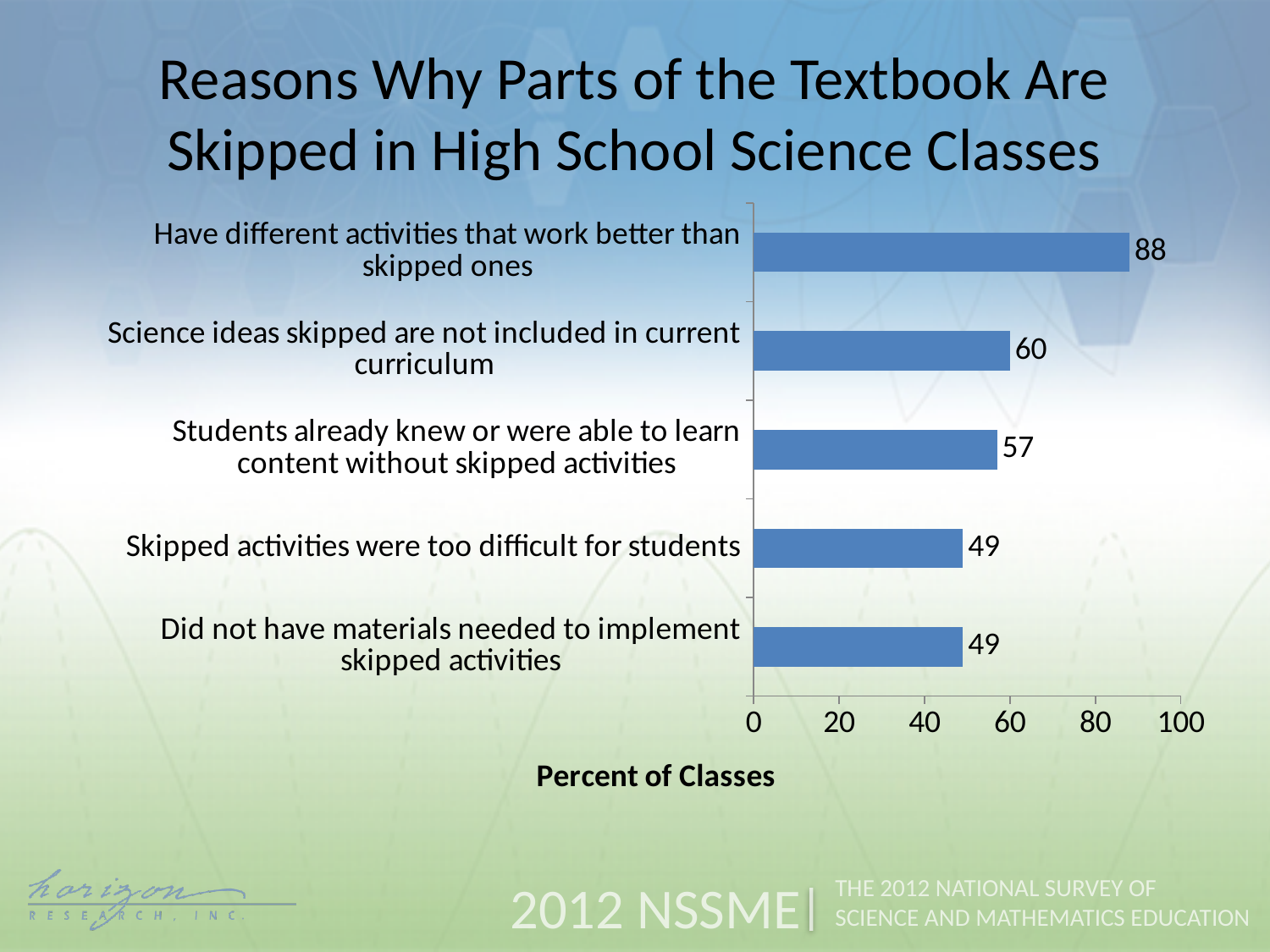
What is the difference between the value for 'Students already knew or were able to learn content without skipped activities' and the value for 'Did not have materials needed to implement skipped activities'? 8 What is the difference between the value for 'Have different activities that work better than skipped ones' and the value for 'Science ideas skipped are not included in current curriculum'? 28 What is the value for 'Skipped activities were too difficult for students'? 49 How many reasons are shown in the chart? 5 What percent of classes reported that students already knew or were able to learn content without skipped activities? 57 What is the value for 'Science ideas skipped are not included in current curriculum'? 60 What is the label of the horizontal axis? Percent of Classes Which reason has the highest percent of classes? Have different activities that work better than skipped ones Which is larger: the value for 'Science ideas skipped are not included in current curriculum' or the value for 'Skipped activities were too difficult for students'? Science ideas skipped are not included in current curriculum What percent of classes skipped parts of the textbook because they have different activities that work better than skipped ones? 88 What kind of chart is shown on the slide? Bar chart Is the value for 'Did not have materials needed to implement skipped activities' greater or less than 60? less